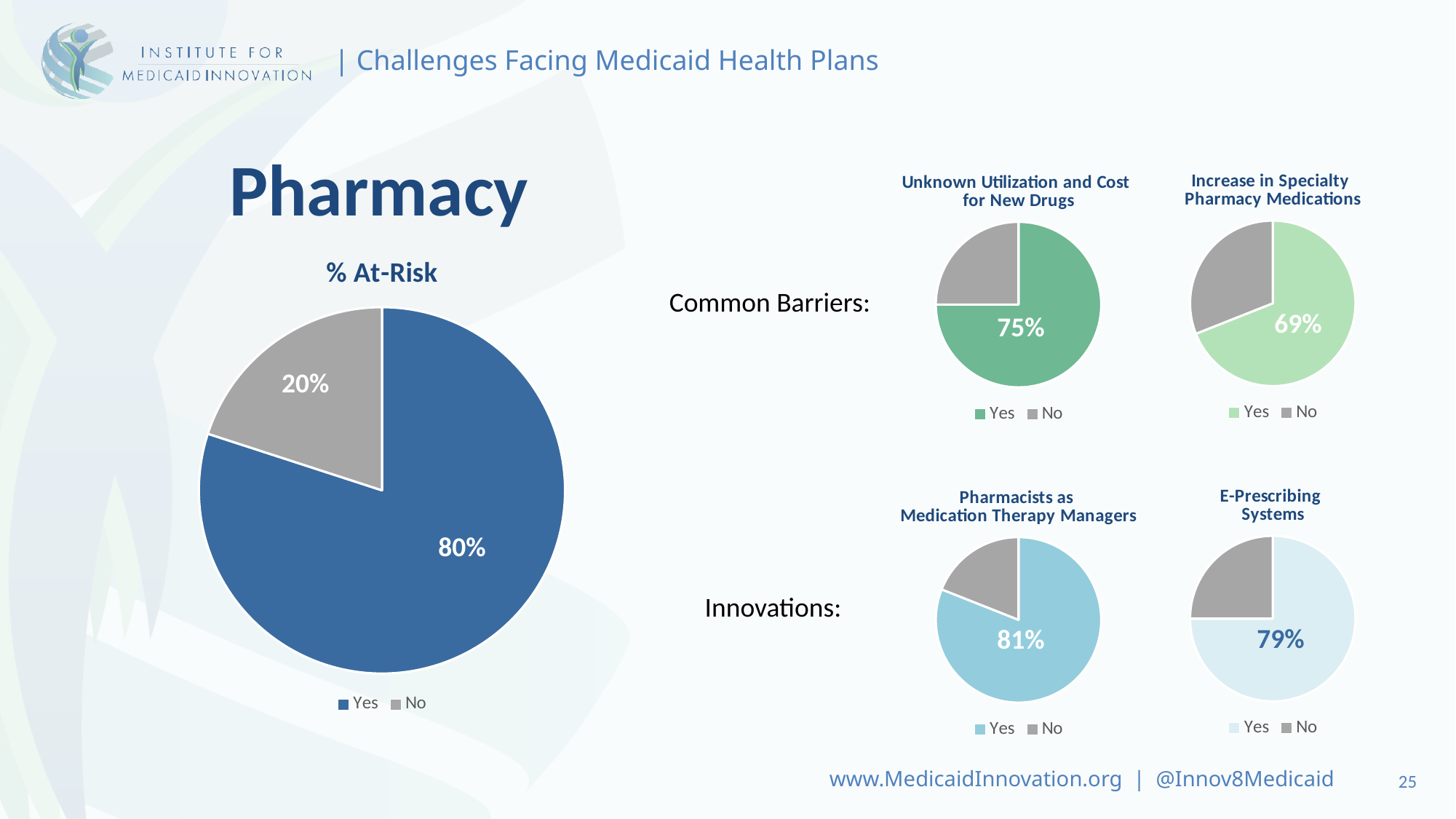
In the "% At-Risk" pie chart, what percentage is shown for the Yes slice? 80% Among the four small pie charts on the right, which one has the highest labelled Yes percentage? Pharmacists as Medication Therapy Managers What kind of chart is the "% At-Risk" chart? Pie chart In the "% At-Risk" pie chart, what is the difference in percentage points between the Yes slice and the No slice? 60 percentage points Which of the two Common Barriers pie charts shows a larger Yes percentage: "Unknown Utilization and Cost for New Drugs" or "Increase in Specialty Pharmacy Medications"? Unknown Utilization and Cost for New Drugs How many entries does the legend of the "% At-Risk" chart list? 2 Among the four small pie charts on the right, which one has the lowest labelled Yes percentage? Increase in Specialty Pharmacy Medications In the "Unknown Utilization and Cost for New Drugs" pie chart, what percentage is labelled on the Yes slice? 75% In the "Pharmacists as Medication Therapy Managers" pie chart, what percentage is labelled on the Yes slice? 81% In the "% At-Risk" pie chart, what percentage is shown for the No slice? 20% In the "E-Prescribing Systems" pie chart, what percentage is labelled on the Yes slice? 79% In the "Increase in Specialty Pharmacy Medications" pie chart, what percentage is labelled on the Yes slice? 69%